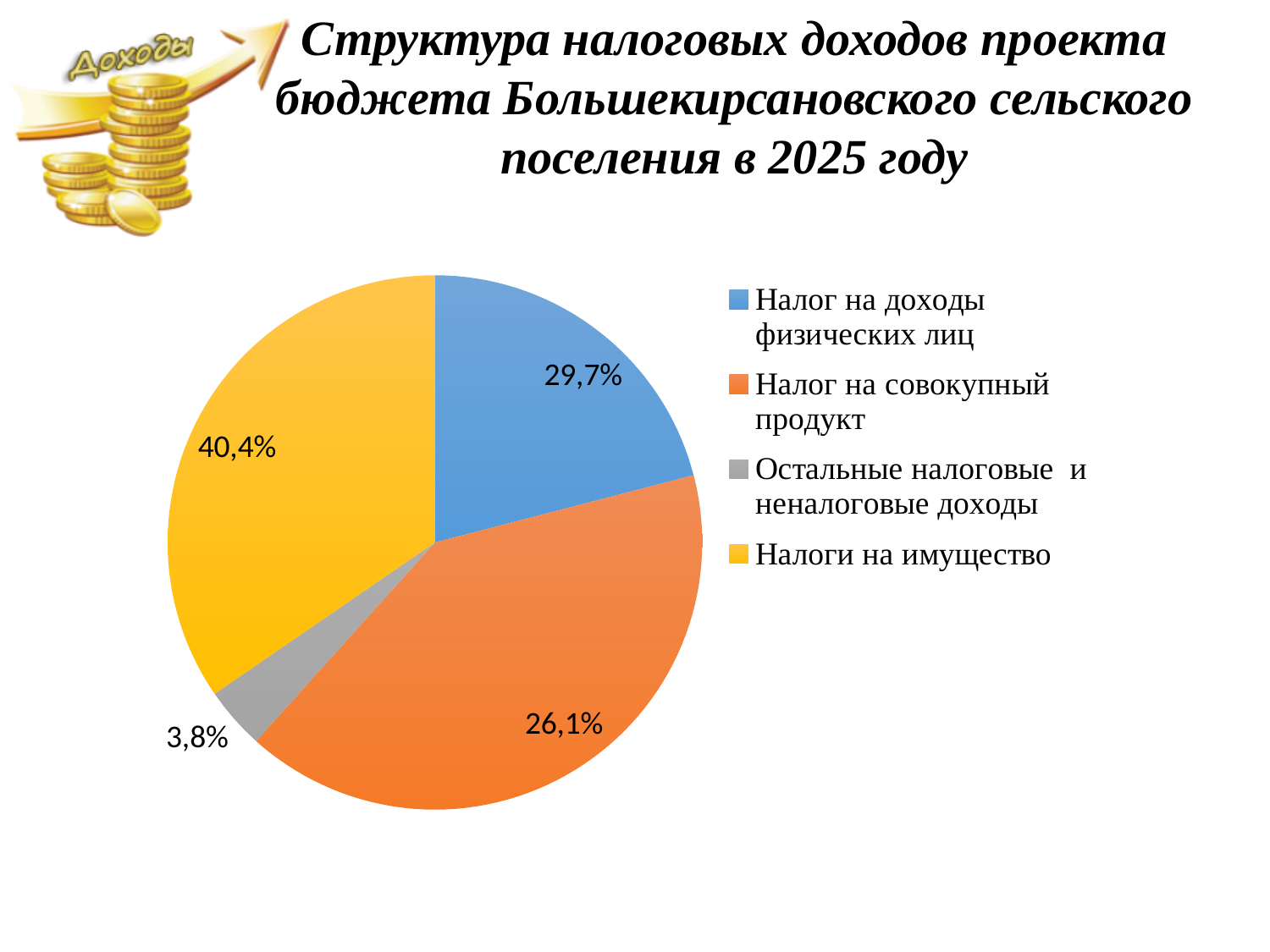
What share of the pie does "Налог на совокупный продукт" have? 26,1% What colour is the slice for "Налог на совокупный продукт"? Orange What is the title of the slide containing the chart? Структура налоговых доходов проекта бюджета Большекирсановского сельского поселения в 2025 году What is the difference in percentage points between "Налоги на имущество" and "Налог на доходы физических лиц"? 10,7 What share of the pie does "Налоги на имущество" have? 40,4% How many categories does the pie chart show? 4 Which category has the smallest slice of the pie? Остальные налоговые и неналоговые доходы What share of the pie does "Остальные налоговые и неналоговые доходы" have? 3,8% What share of the pie does "Налог на доходы физических лиц" have? 29,7% What kind of chart is shown on the slide? Pie chart